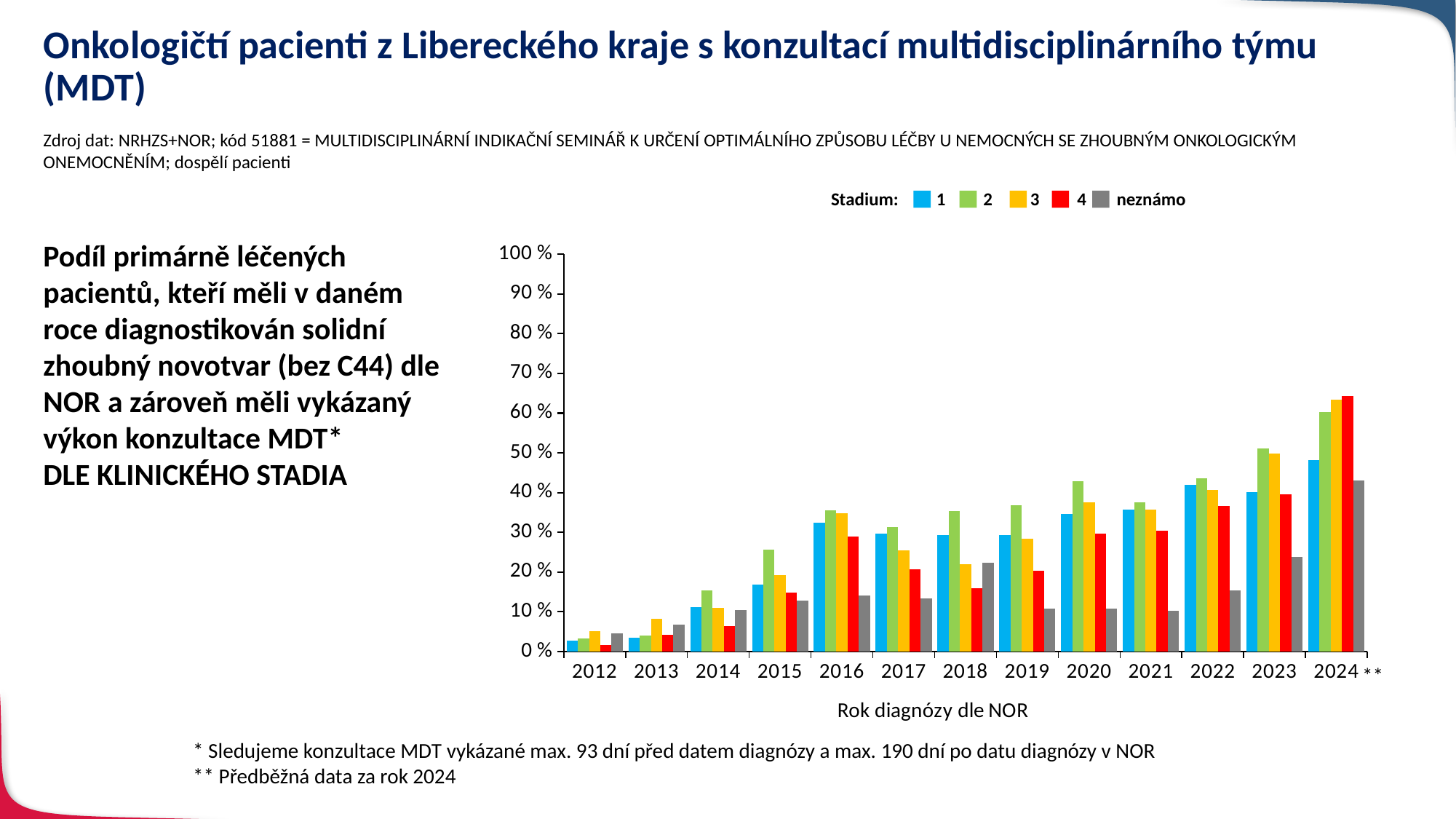
In 2020, which is larger: the value for Stadium 2 or the value for Stadium 4? Stadium 2 Which stadium has the lowest value in 2024? neznámo Is the value for 'neznámo' in 2019 greater or less than 20 %? less What is the title of the x axis of the chart? Rok diagnózy dle NOR How many series does the legend (Stadium) list? 5 How many years are shown on the x axis of the chart? 13 What kind of chart is shown on the slide? bar chart Is the value for Stadium 4 in 2016 greater or less than 20 %? greater Does the value for Stadium 1 generally rise or fall from 2012 to 2024? rise In which year is the value for Stadium 4 the highest? 2024 In 2023, which is larger: the value for Stadium 1 or the value for Stadium 2? Stadium 2 Is the value for Stadium 2 in 2024 greater or less than 50 %? greater